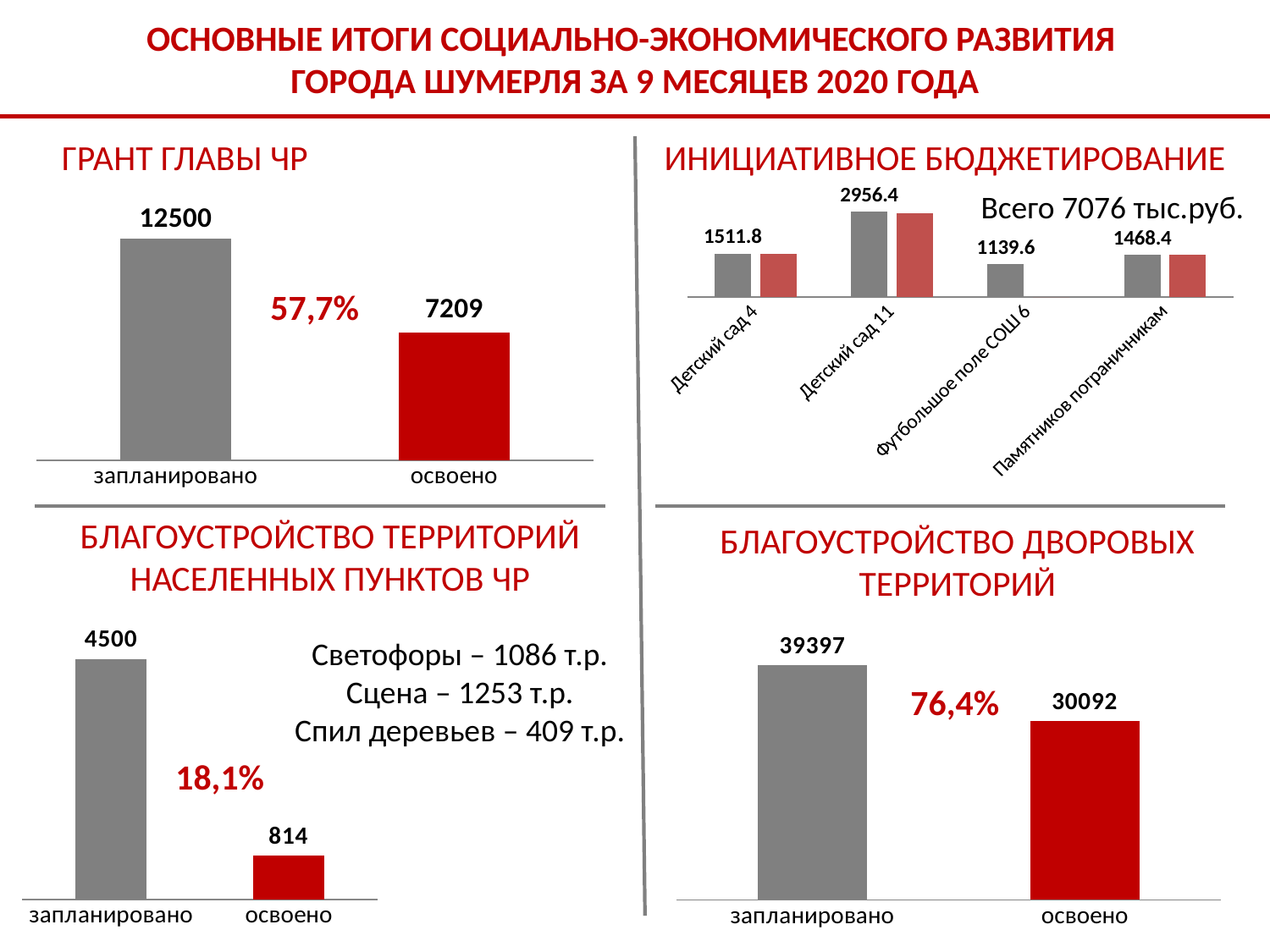
In the 'ГРАНТ ГЛАВЫ ЧР' chart, what is the value for 'освоено'? 7209 In the 'ИНИЦИАТИВНОЕ БЮДЖЕТИРОВАНИЕ' chart, which category has the lowest labelled value? Футбольшое поле СОШ 6 How many categories are shown in the 'ИНИЦИАТИВНОЕ БЮДЖЕТИРОВАНИЕ' chart? 4 In the 'БЛАГОУСТРОЙСТВО ТЕРРИТОРИЙ НАСЕЛЕННЫХ ПУНКТОВ ЧР' chart, what is the value for 'освоено'? 814 In the 'ИНИЦИАТИВНОЕ БЮДЖЕТИРОВАНИЕ' chart, what is the value labelled for 'Детский сад 11'? 2956.4 What type of chart is the 'БЛАГОУСТРОЙСТВО ДВОРОВЫХ ТЕРРИТОРИЙ' chart? bar chart In the 'ИНИЦИАТИВНОЕ БЮДЖЕТИРОВАНИЕ' chart, what is the difference between the labelled values for 'Детский сад 11' and 'Детский сад 4'? 1444.6 In the 'ГРАНТ ГЛАВЫ ЧР' chart, what is the value for 'запланировано'? 12500 In the 'БЛАГОУСТРОЙСТВО ДВОРОВЫХ ТЕРРИТОРИЙ' chart, which is larger, 'запланировано' or 'освоено'? запланировано In the 'БЛАГОУСТРОЙСТВО ДВОРОВЫХ ТЕРРИТОРИЙ' chart, what is the difference between 'запланировано' and 'освоено'? 9305 In the 'ГРАНТ ГЛАВЫ ЧР' chart, what is the difference between 'запланировано' and 'освоено'? 5291 In the 'ИНИЦИАТИВНОЕ БЮДЖЕТИРОВАНИЕ' chart, which category has the highest labelled value? Детский сад 11